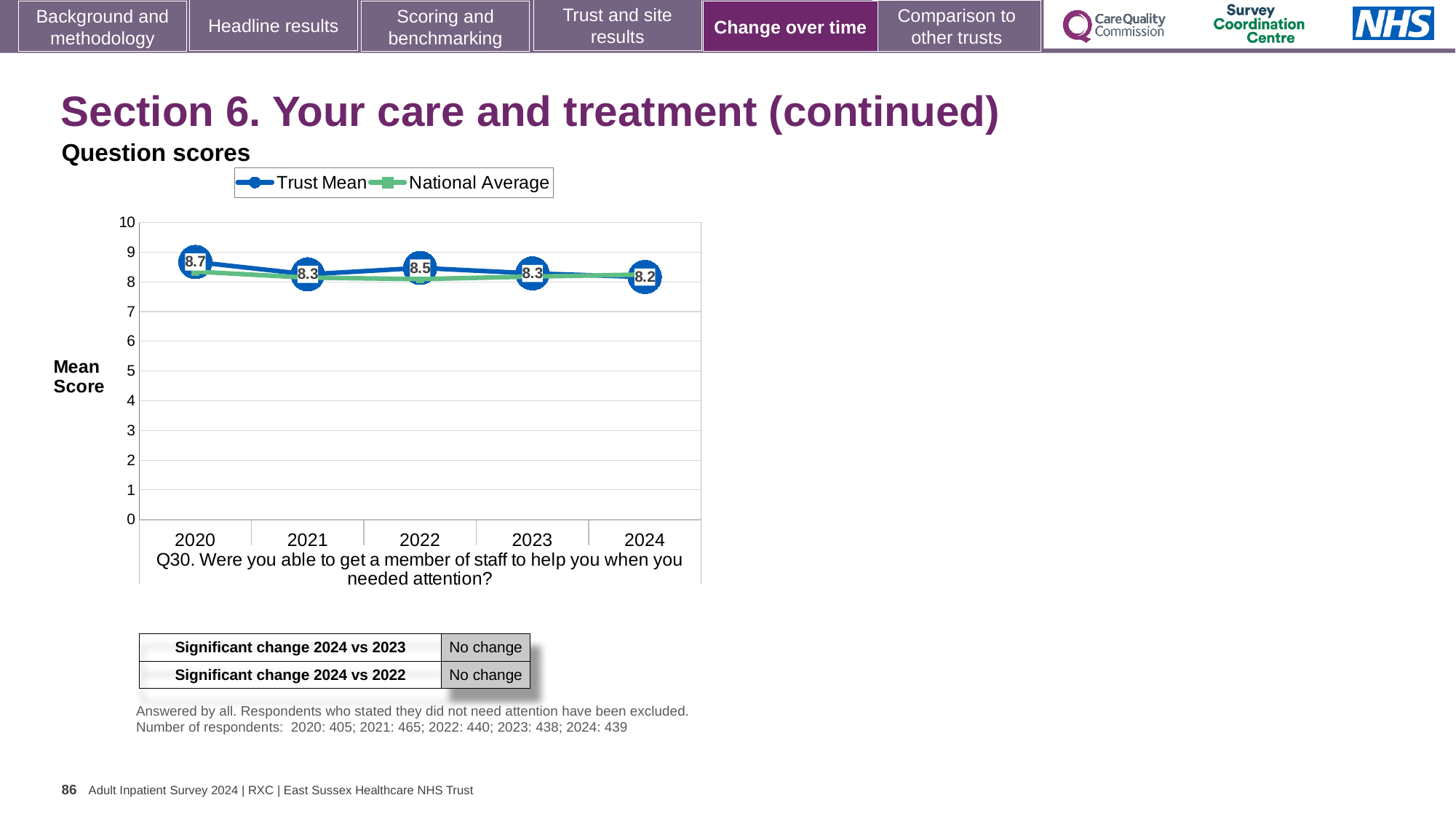
How many years are plotted on the x axis? 5 What is the Trust Mean value for 2024? 8.2 Is the National Average value for 2020 greater or less than 9? less What is the Trust Mean value for 2020? 8.7 How many series does the legend list? 2 In which year is the Trust Mean lowest? 2024 In which year is the Trust Mean highest? 2020 What is the difference between the Trust Mean in 2020 and in 2024? 0.5 Which year has the larger Trust Mean, 2021 or 2022? 2022 What is the Trust Mean value for 2022? 8.5 Does the Trust Mean rise or fall overall from 2020 to 2024? Fall What kind of chart is shown on the slide? Line chart